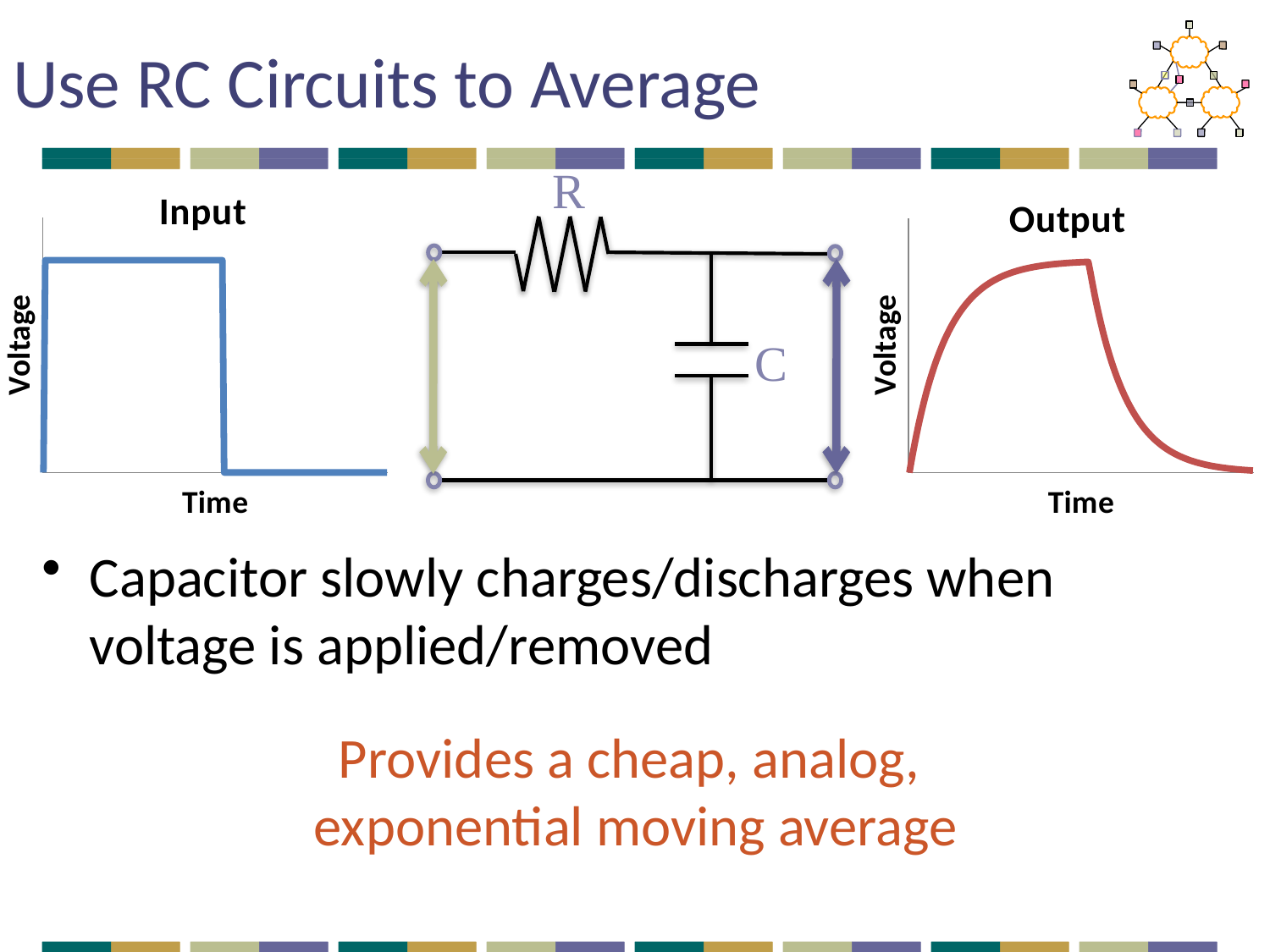
In the Output chart, does the voltage rise or fall over the last part of the time axis? fall What kind of chart is the Output chart? line chart What kind of chart is the Input chart? line chart In the Output chart, does the voltage rise or fall over the first part of the time axis? rise What is the label on the horizontal axis of the Input chart? Time In the Input chart, does the voltage rise or fall at the step in the middle of the time axis? fall What is the label on the vertical axis of the Output chart? Voltage